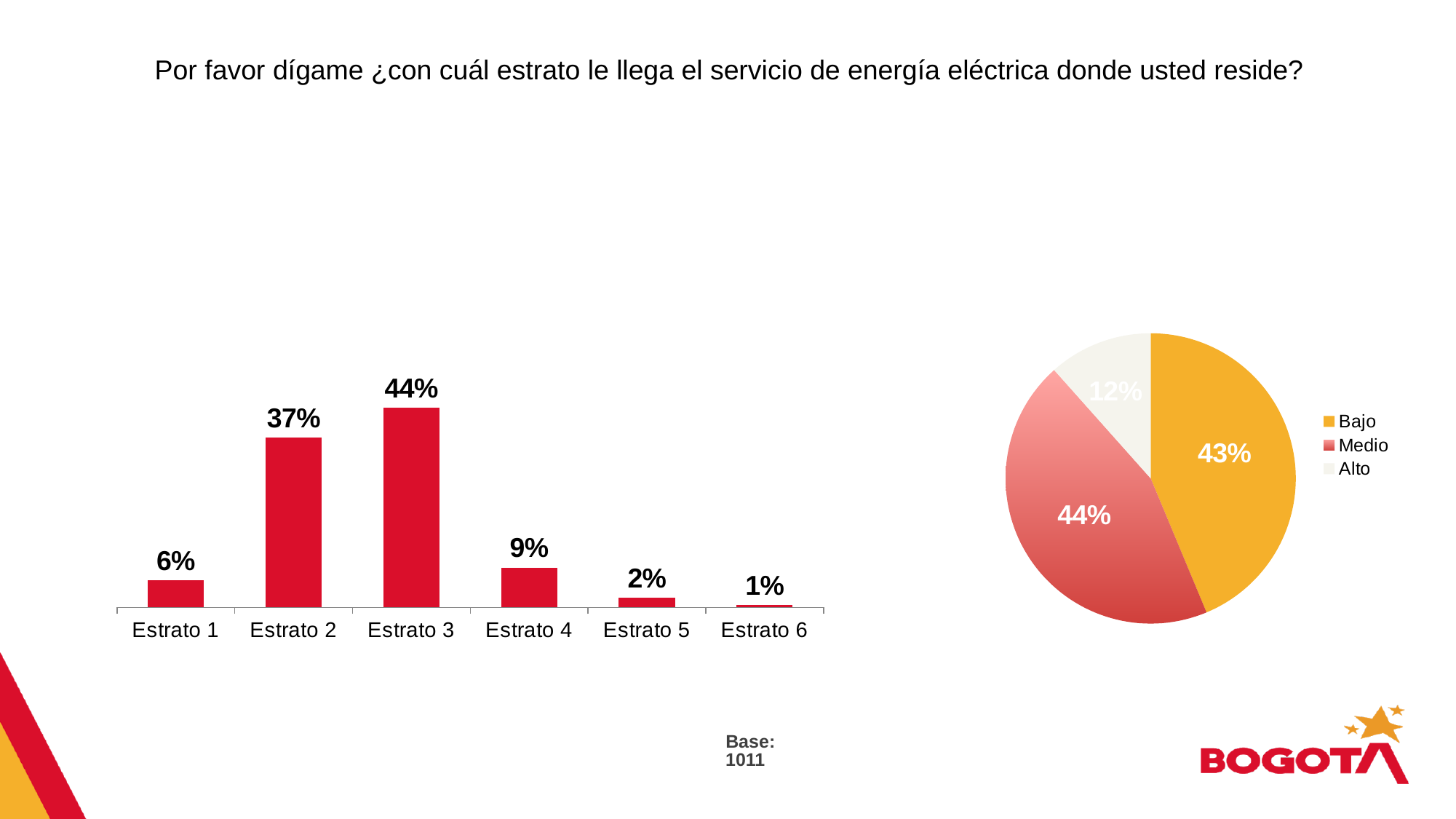
In the bar chart on the left, which category has the highest value? Estrato 3 What kind of chart is the chart on the left of the slide? Bar chart In the bar chart on the left, what is the value for Estrato 3? 44% In the pie chart on the right, which colour is used for the Bajo slice? Orange In the pie chart on the right, what is the share for Alto? 12% In the bar chart on the left, what is the value for Estrato 1? 6% In the bar chart on the left, which category has the lowest value? Estrato 6 How many categories does the bar chart on the left show? 6 How many entries does the legend of the pie chart on the right list? 3 In the bar chart on the left, what is the difference between the values for Estrato 3 and Estrato 2? 7% In the bar chart on the left, which is larger, the value for Estrato 4 or the value for Estrato 5? Estrato 4 In the pie chart on the right, what is the share for Medio? 44%